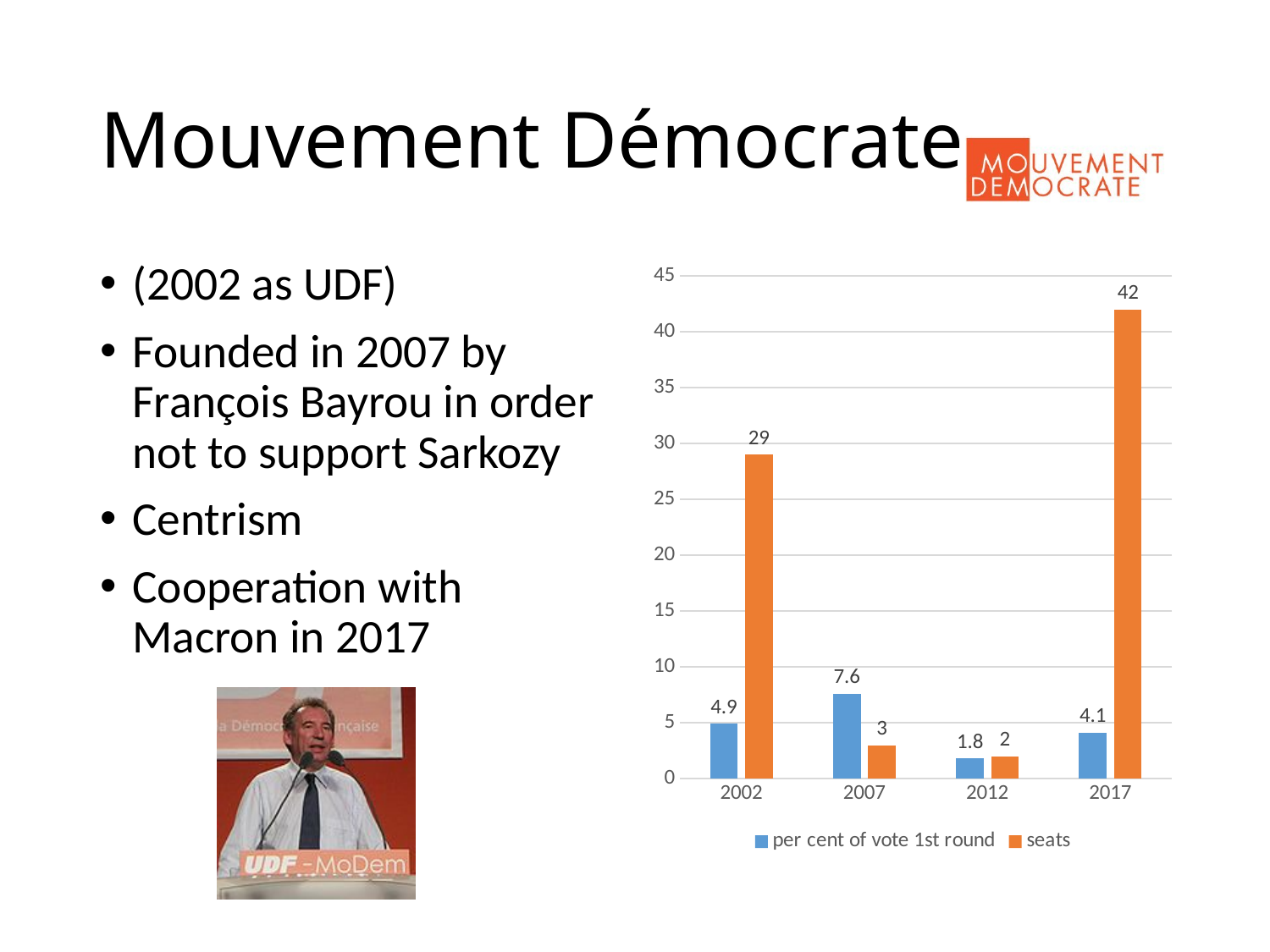
Is the number of seats in 2017 greater or less than 40? greater Which colour represents the seats series? orange In which year is the number of seats highest? 2017 What is the per cent of vote 1st round in 2007? 7.6 Which is larger: the per cent of vote 1st round in 2002 or in 2017? 2002 What is the difference in seats between 2017 and 2002? 13 What is the number of seats in 2017? 42 How many series does the legend list? 2 What kind of chart is shown on the slide? bar chart In which year is the per cent of vote 1st round lowest? 2012 What is the number of seats in 2002? 29 How many years are shown on the x axis? 4